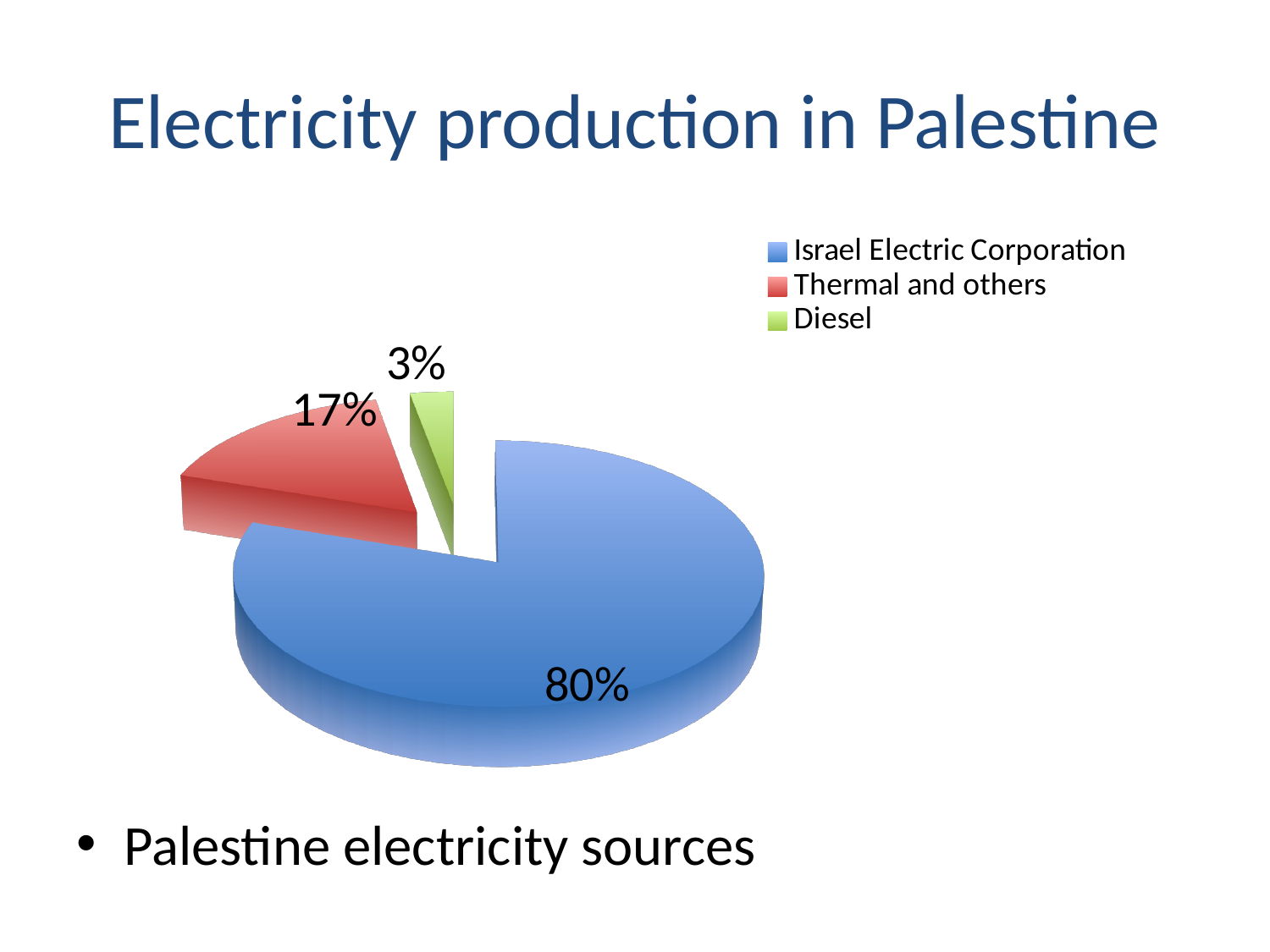
Which is larger, the share for Thermal and others or the share for Diesel? Thermal and others Which source has the smallest share of electricity production? Diesel What kind of chart is shown on the slide? Pie chart What share of electricity production comes from Thermal and others? 17% What colour is the slice for Diesel? Green What share of electricity production comes from Israel Electric Corporation? 80% What share of electricity production comes from Diesel? 3% How many percentage points larger is the Israel Electric Corporation share than the Thermal and others share? 63 Which source has the largest share of electricity production? Israel Electric Corporation How many entries does the legend list? 3 How many slices does the pie chart have? 3 How many percentage points larger is the Thermal and others share than the Diesel share? 14